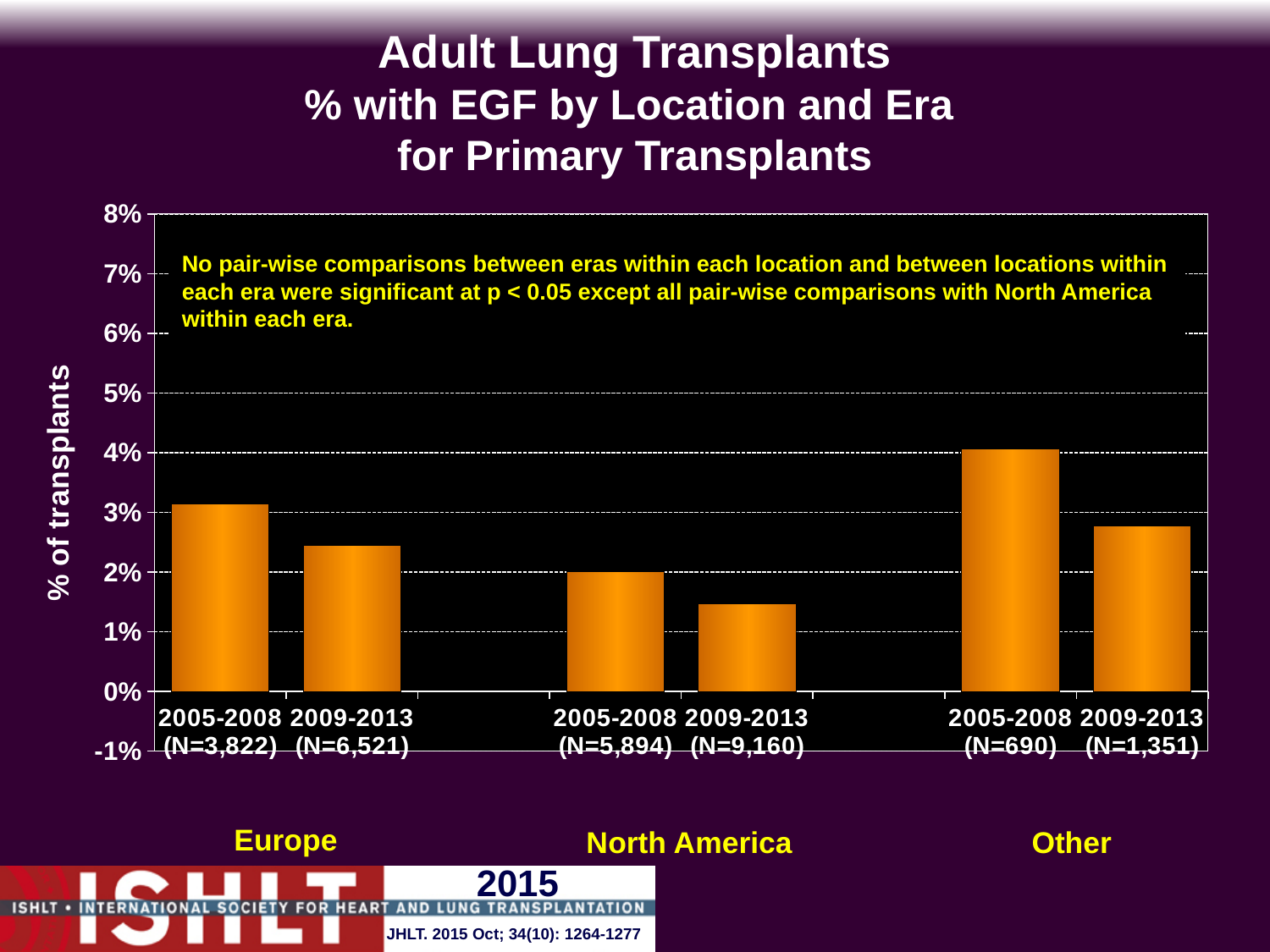
Is the value for Europe 2005-2008 greater or less than 2%? greater How many bars are plotted in the chart? 6 Which location and era has the lowest % of transplants with EGF? North America, 2009-2013 Is the value for Other 2005-2008 greater or less than 3%? greater Is the value for Other 2009-2013 greater or less than 2%? greater What kind of chart is shown on the slide? bar chart Which is larger, the value for Europe 2005-2008 or Europe 2009-2013? Europe 2005-2008 What is the label on the y axis of the chart? % of transplants Which location and era has the highest % of transplants with EGF? Other, 2005-2008 Within each location, does the % with EGF rise or fall from the 2005-2008 era to the 2009-2013 era? fall